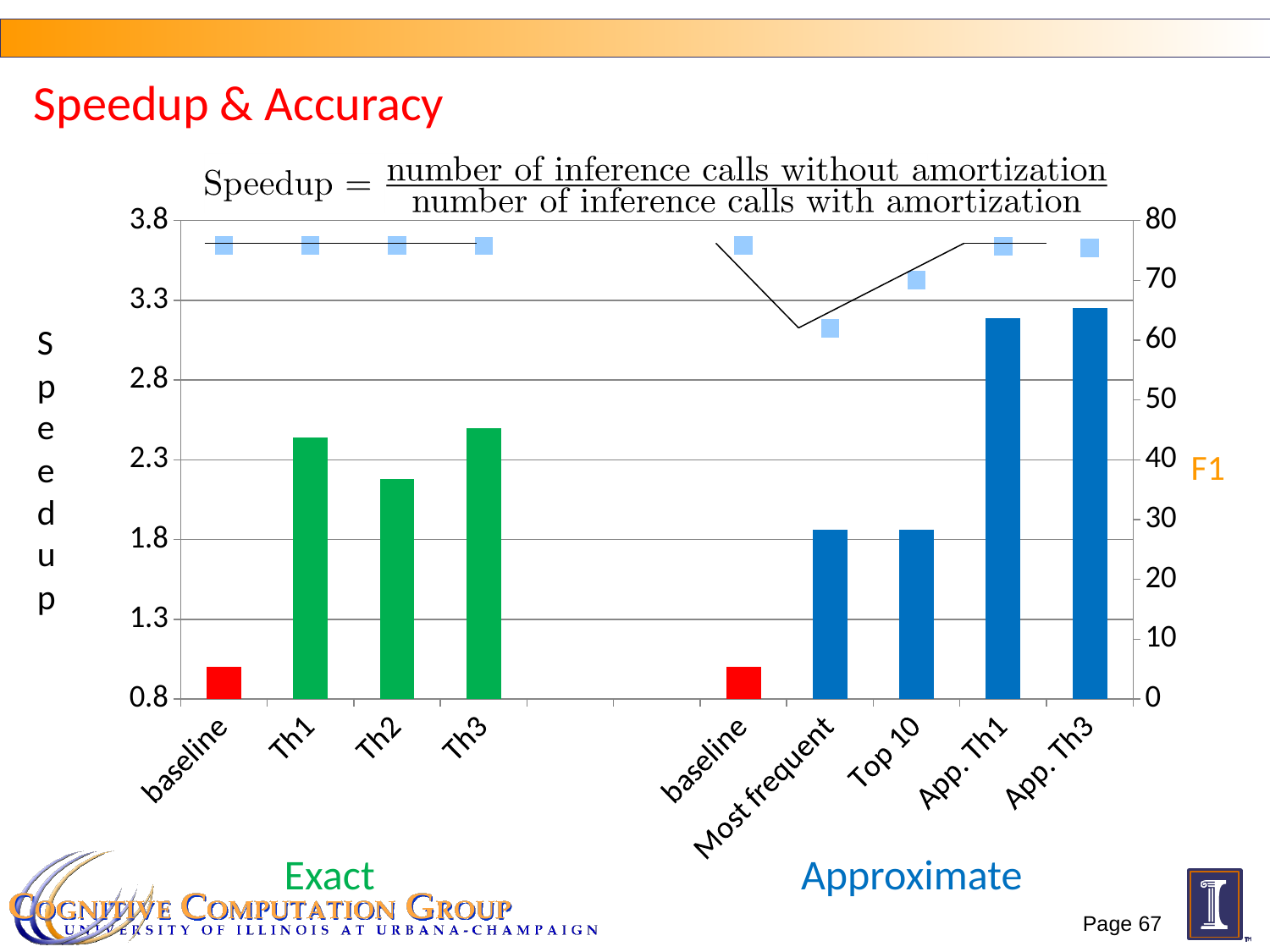
Is the speedup value for Th2 greater or less than 2.3? less Is the speedup value for Th1 greater or less than 2.3? greater What kind of chart is shown on the slide? bar chart How many categories are shown along the x axis of the chart? 9 What is the title of the slide containing the chart? Speedup & Accuracy Is the speedup value for the Exact baseline greater or less than 1.3? less Which has the larger speedup, App. Th1 or Top 10? App. Th1 Among Th1, Th2 and Th3, which has the lowest speedup? Th2 Which has the larger speedup, Th1 or Th2? Th1 What label is shown on the right-hand axis of the chart? F1